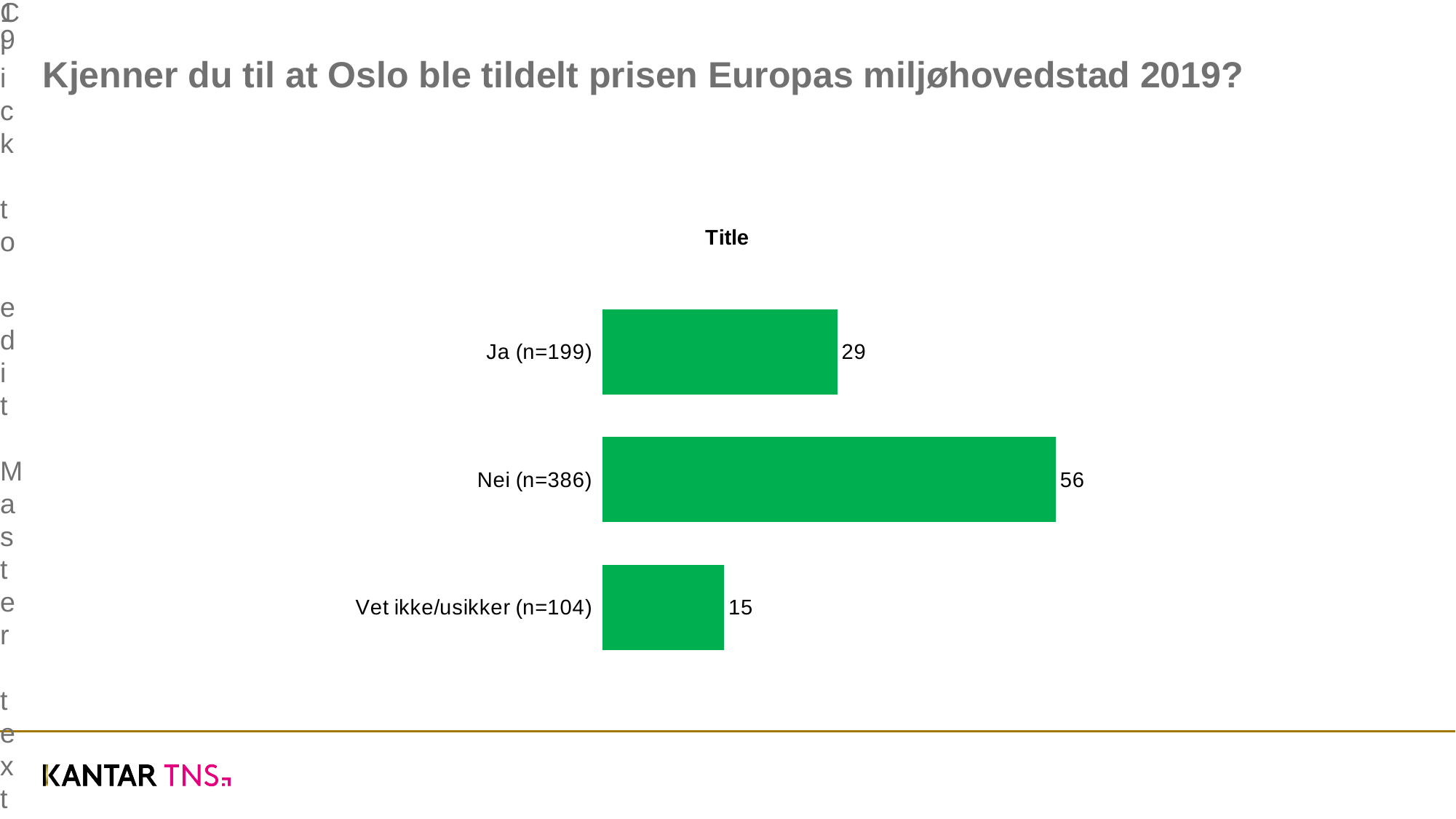
What is the difference between the values for Ja (n=199) and Vet ikke/usikker (n=104)? 14 What is the value for Nei (n=386)? 56 Which is larger, the value for Ja (n=199) or the value for Vet ikke/usikker (n=104)? Ja (n=199) What is the value for Ja (n=199)? 29 What is the value for Vet ikke/usikker (n=104)? 15 Which category has the highest value? Nei (n=386) What is the title printed above the chart? Title What colour are the bars in the chart? Green How many categories are shown in the chart? 3 What kind of chart is shown on the slide? Bar chart What is the difference between the values for Nei (n=386) and Ja (n=199)? 27 Which category has the lowest value? Vet ikke/usikker (n=104)